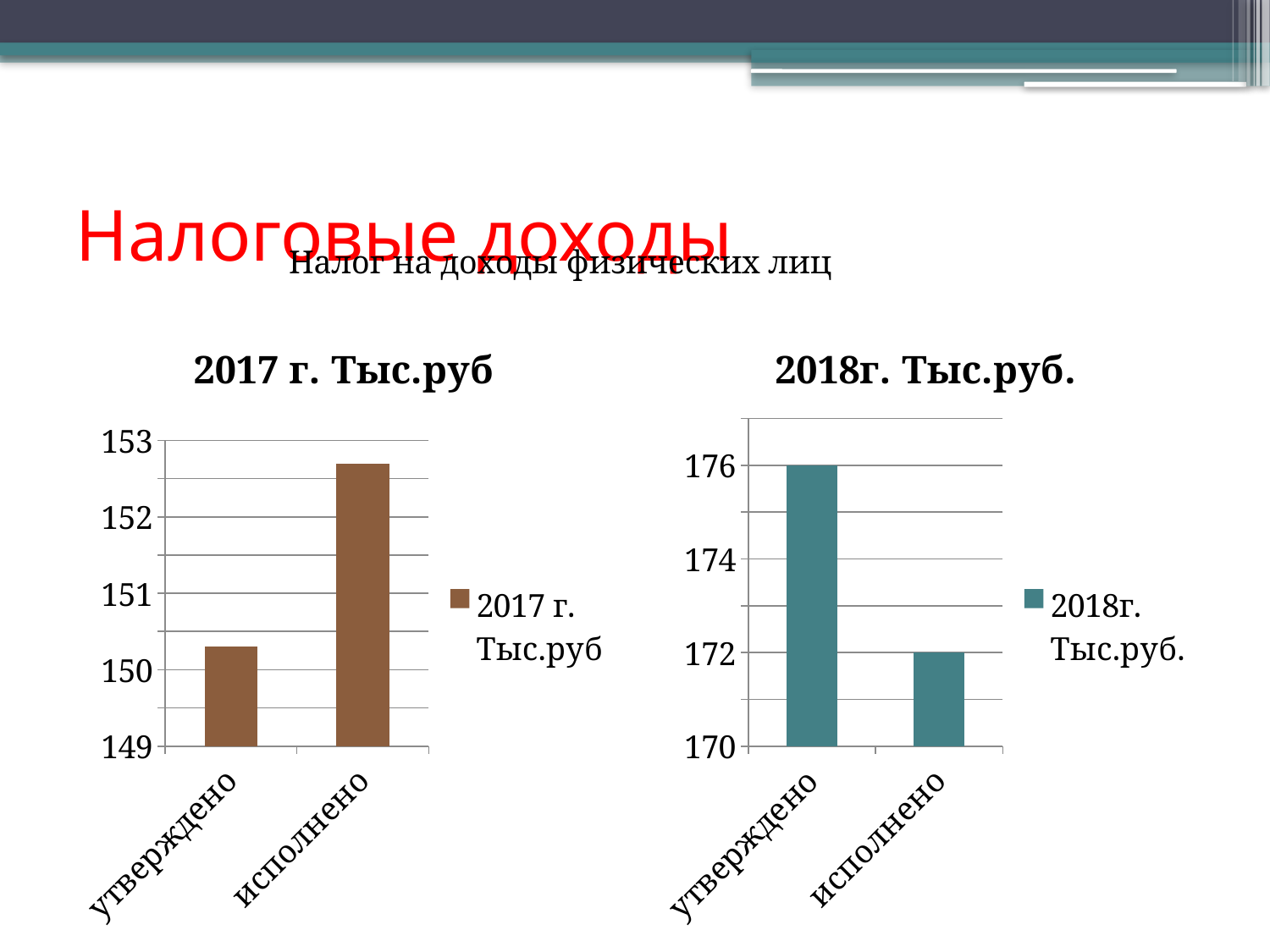
What type of chart is the chart titled "2017 г. Тыс.руб"? bar chart In the chart titled "2017 г. Тыс.руб", which category has the lower value? утверждено In the chart titled "2017 г. Тыс.руб", is the value for исполнено greater or less than 152? greater In the chart titled "2018г. Тыс.руб.", what is the value for исполнено? 172 How many series does the legend of the chart titled "2017 г. Тыс.руб" list? 1 In the chart titled "2018г. Тыс.руб.", what is the value for утверждено? 176 In the chart titled "2017 г. Тыс.руб", is исполнено larger or smaller than утверждено? larger How many categories are shown in the chart titled "2018г. Тыс.руб."? 2 What is the legend entry of the chart on the right side of the slide? 2018г. Тыс.руб. In the chart titled "2018г. Тыс.руб.", which category has the higher value? утверждено In the chart titled "2018г. Тыс.руб.", what is the difference between утверждено and исполнено? 4 In the chart titled "2017 г. Тыс.руб", is the value for утверждено greater or less than 151? less